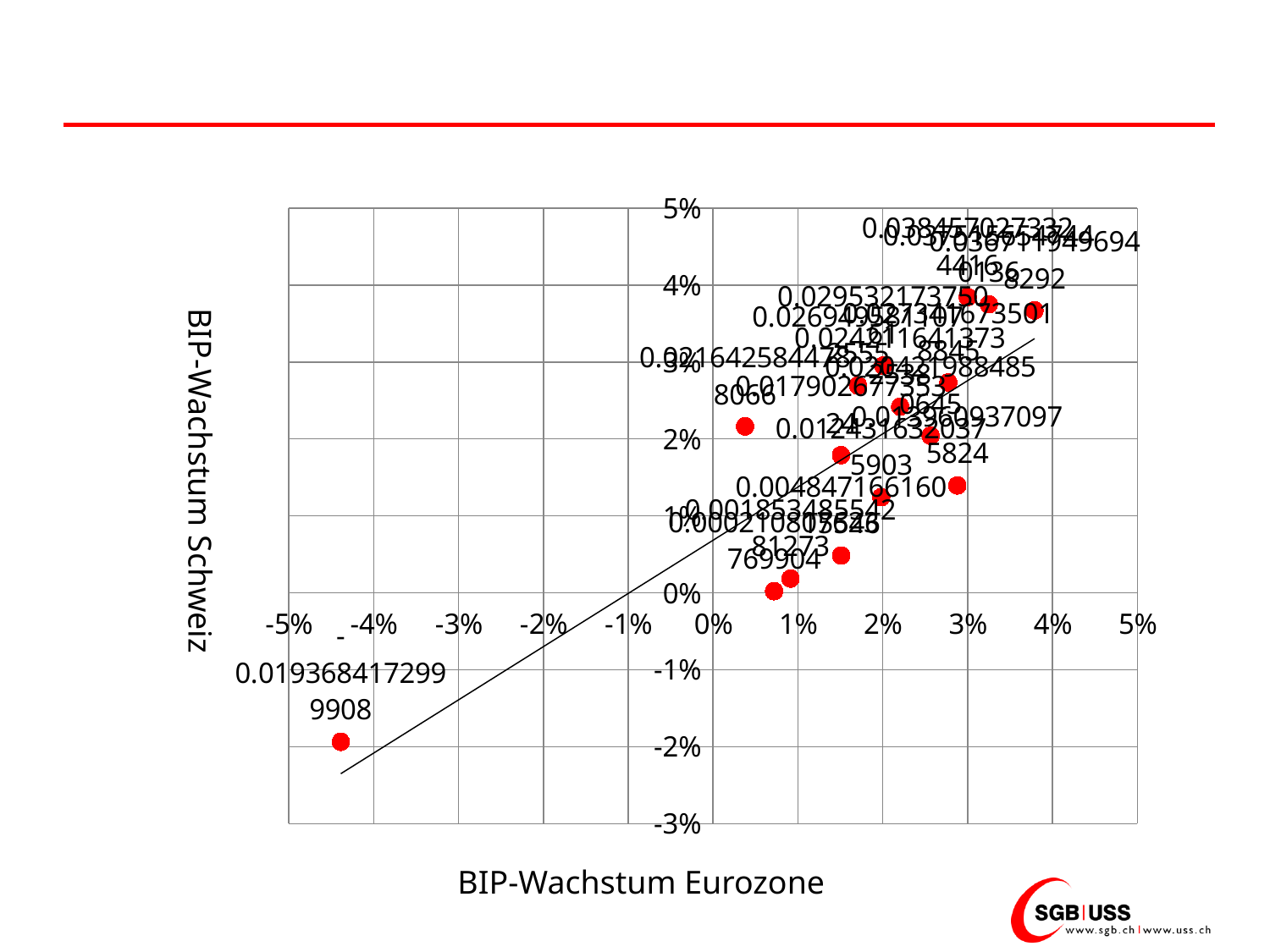
Is the BIP-Wachstum Eurozone value of the lowest point greater or less than -4%? less Is the BIP-Wachstum Eurozone value of the rightmost point greater or less than 3%? greater What is the title of the vertical axis? BIP-Wachstum Schweiz What data label is printed next to the lowest point in the chart? -0.0193684172999908 What is the lowest value shown on the vertical axis? -3% What kind of chart is shown on the slide? scatter chart Is the BIP-Wachstum Schweiz value of the highest point greater or less than 3%? greater Do the values for BIP-Wachstum Schweiz generally rise or fall as BIP-Wachstum Eurozone increases? rise What is the title of the horizontal axis? BIP-Wachstum Eurozone